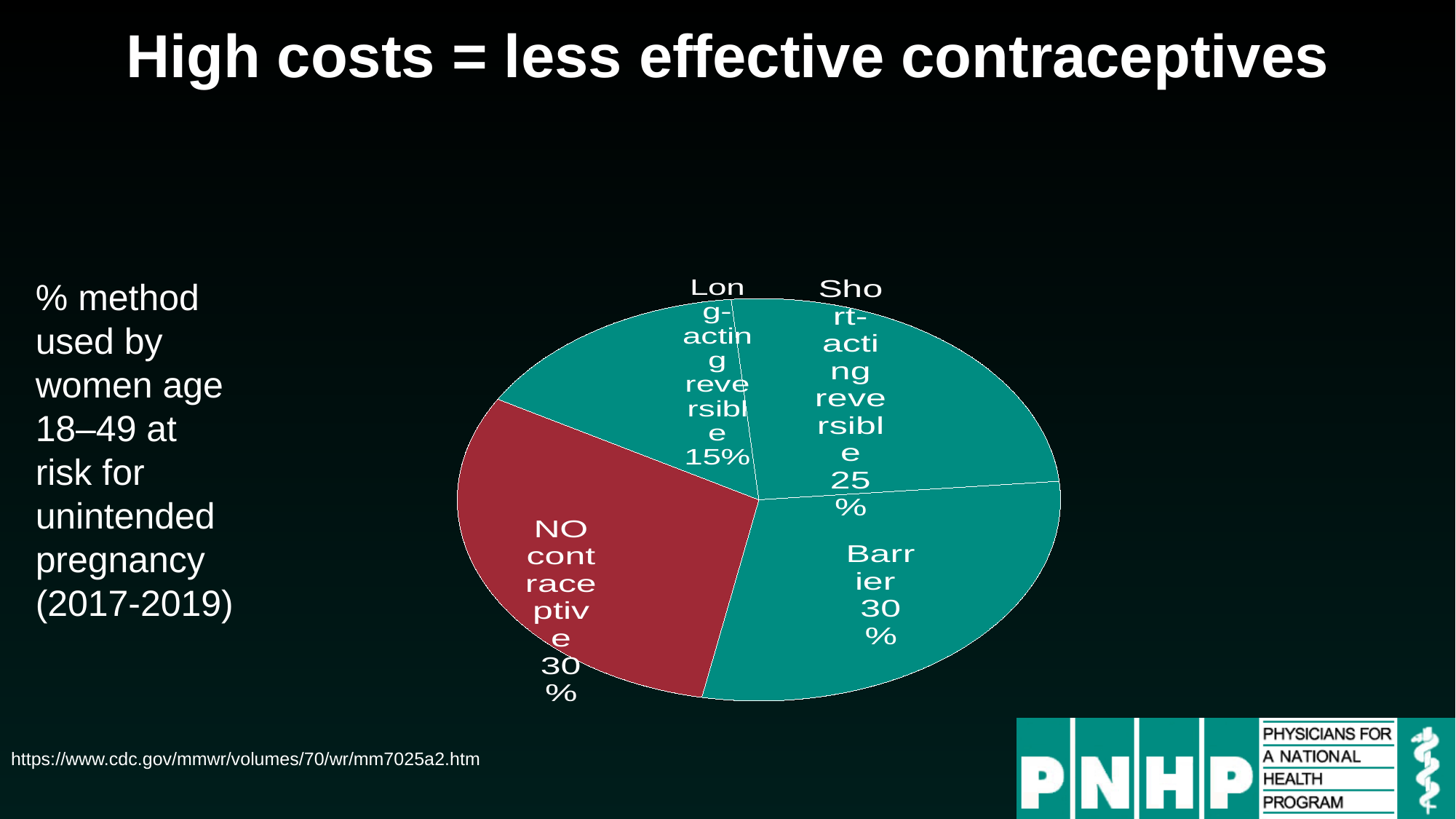
Which slice of the pie is the smallest? Long-acting reversible What kind of chart is shown on the slide? pie chart What percentage of the pie is labelled Barrier? 30% Which is larger, the Short-acting reversible slice or the Long-acting reversible slice? Short-acting reversible What is the title of the slide containing the pie chart? High costs = less effective contraceptives What is the difference in percentage points between the Barrier slice and the Long-acting reversible slice? 15 What percentage of the pie is labelled Long-acting reversible? 15% Which slice of the pie chart is coloured red rather than teal? NO contraceptive What percentage of the pie is labelled Short-acting reversible? 25% What is the difference in percentage points between the Short-acting reversible slice and the Long-acting reversible slice? 10 What percentage of the pie is labelled NO contraceptive? 30% How many slices does the pie chart have? 4